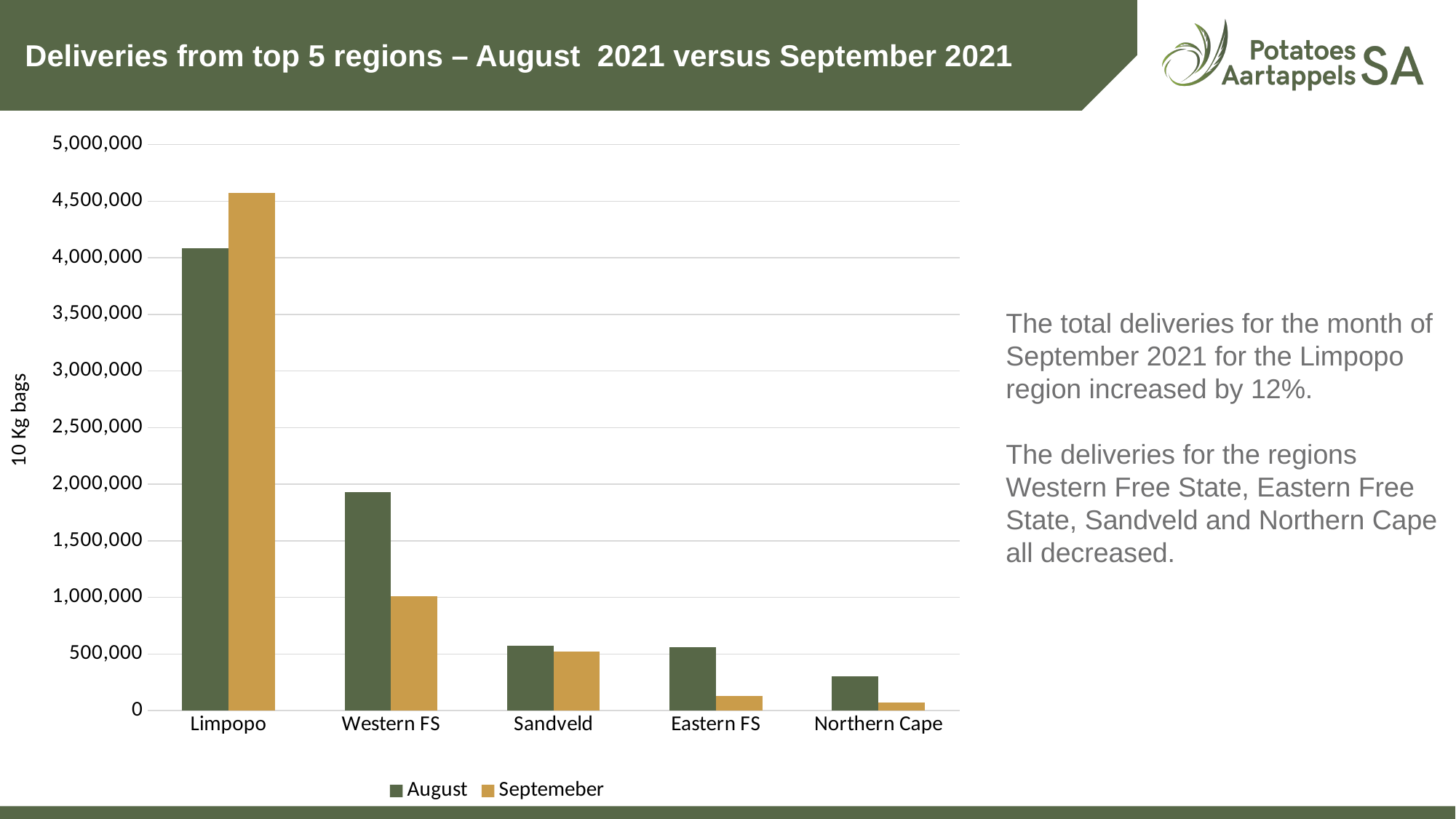
How many regions are shown on the x axis of the chart? 5 Do the August values rise or fall moving from Limpopo to Northern Cape along the x axis? Fall For Western FS, which is larger: the August value or the September value? August Is the August value for Western FS greater or less than 1,500,000? greater Which region has the highest August deliveries? Limpopo What is the label on the vertical axis of the chart? 10 Kg bags Is the September value for Limpopo greater or less than 4,000,000? greater For Limpopo, which is larger: the August value or the September value? September Is the September value for Eastern FS greater or less than 500,000? less Which region has the lowest September deliveries? Northern Cape How many series does the chart legend list? 2 What kind of chart is shown on the slide? Bar chart